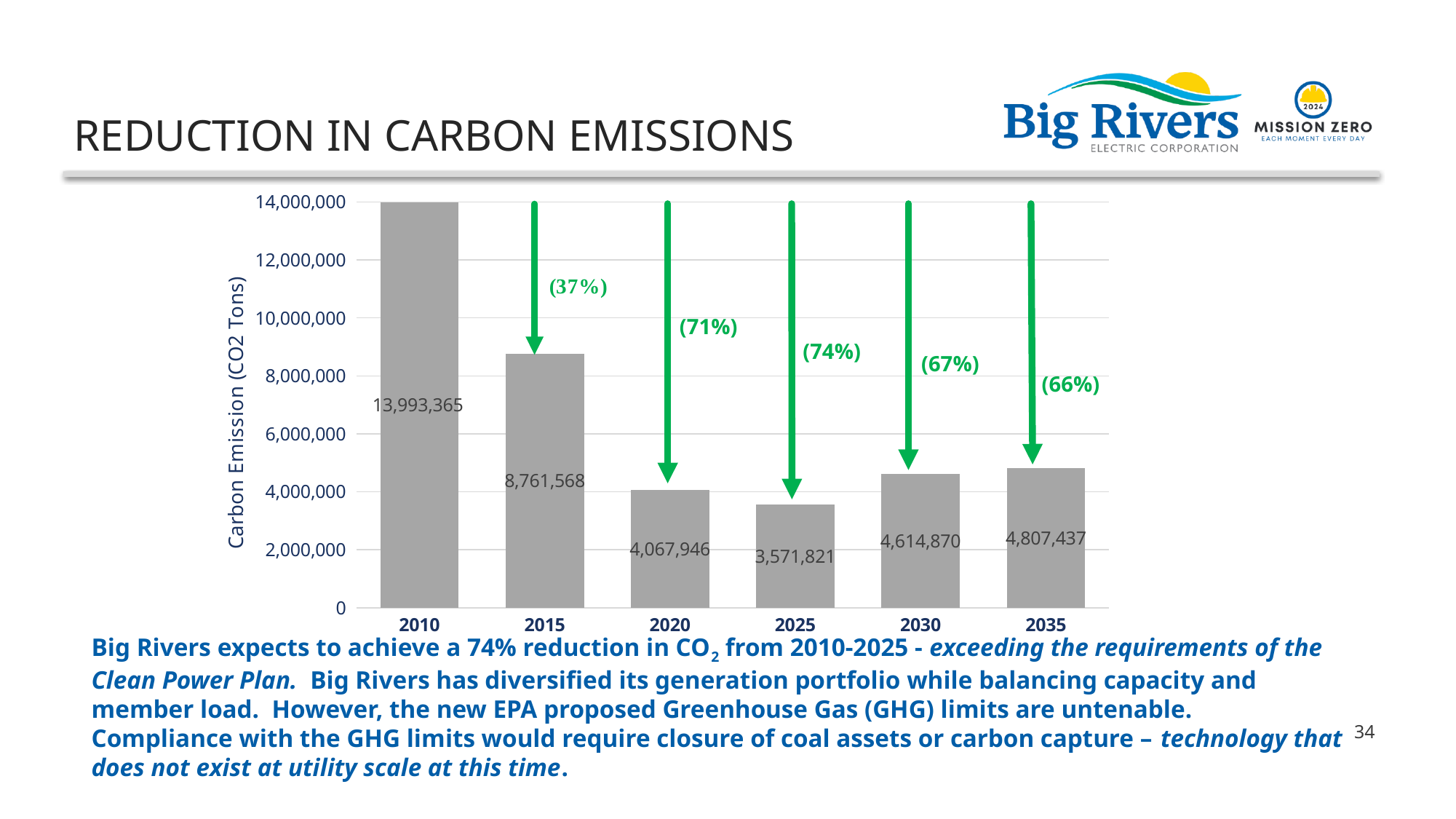
Which year has higher carbon emissions, 2020 or 2030? 2030 What is the difference in carbon emissions between 2010 and 2015? 5,231,797 What is the label of the y axis? Carbon Emission (CO2 Tons) What is the carbon emission value for 2025? 3,571,821 What is the carbon emission value for 2010? 13,993,365 What kind of chart is shown on the slide? Bar chart Is the value for 2015 greater or less than 8,000,000? greater What is the carbon emission value for 2035? 4,807,437 How many years are shown on the x axis? 6 Which year has the highest carbon emission? 2010 What percentage reduction is labelled above the 2020 bar? (71%) Which year has the lowest carbon emission? 2025